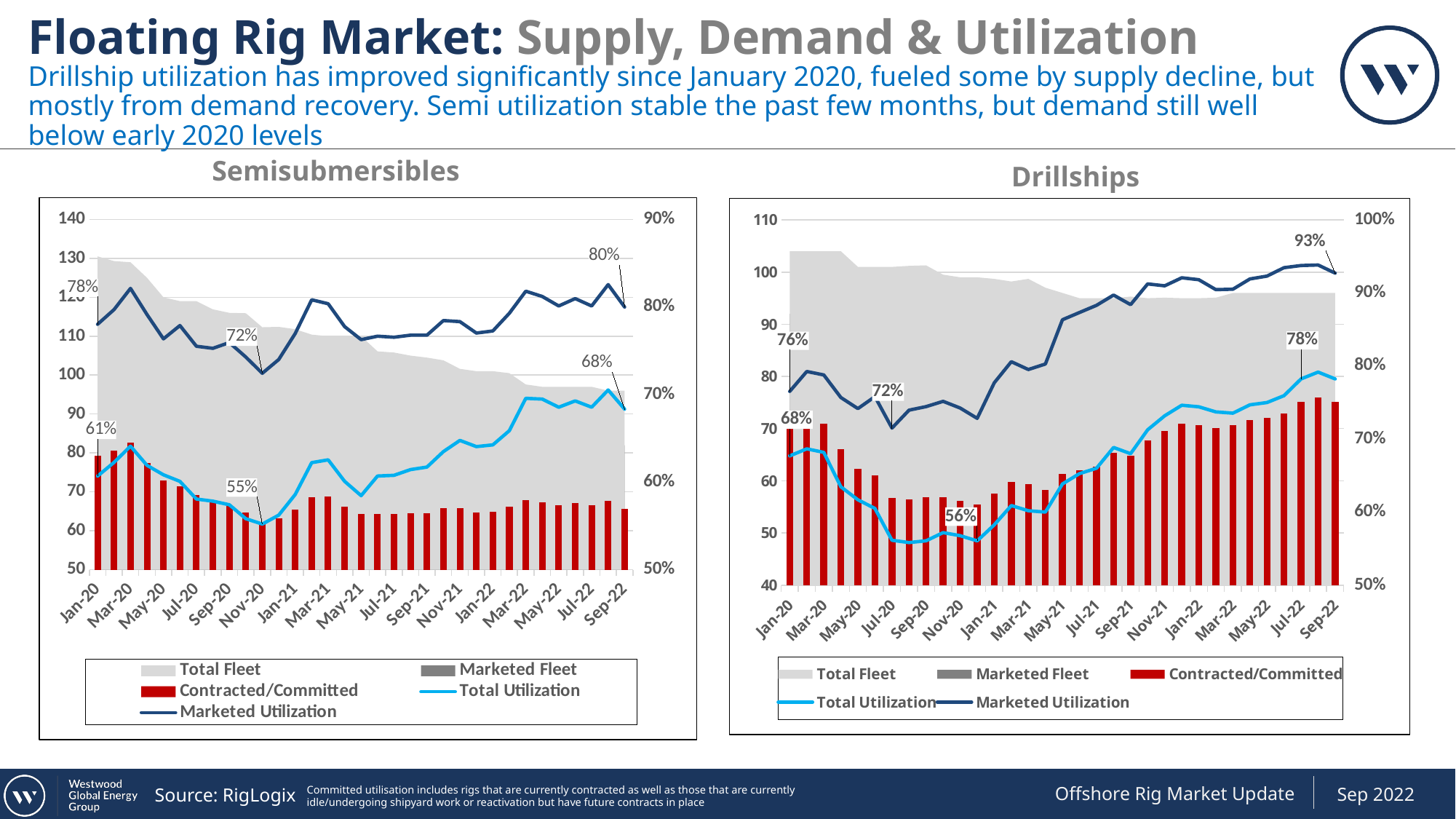
On the Semisubmersibles chart, what is the Marketed Utilization value labelled for Sep-22? 80% On the Drillships chart, what is the Marketed Utilization value labelled for Sep-22? 93% On the Semisubmersibles chart, is the Total Fleet value for Jan-20 greater or less than 120? greater On the Drillships chart, what is the Total Utilization value labelled for Jan-20? 68% On the Drillships chart, what is the Marketed Utilization value labelled for Jul-20? 72% On the Semisubmersibles chart, what is the Total Utilization value labelled for Nov-20? 55% On the Semisubmersibles chart, what colour are the Contracted/Committed bars? red How many series does the legend of the Drillships chart list? 5 On the Drillships chart, what is the difference between the labelled Marketed Utilization and Total Utilization for Sep-22? 15 percentage points On the Semisubmersibles chart, by how much did the labelled Total Utilization rise from Nov-20 to Sep-22? 13 percentage points Which chart shows the higher labelled Marketed Utilization for Sep-22, Semisubmersibles or Drillships? Drillships On the Drillships chart, does the Total Utilization line rise or fall from Nov-20 to Sep-22? rise